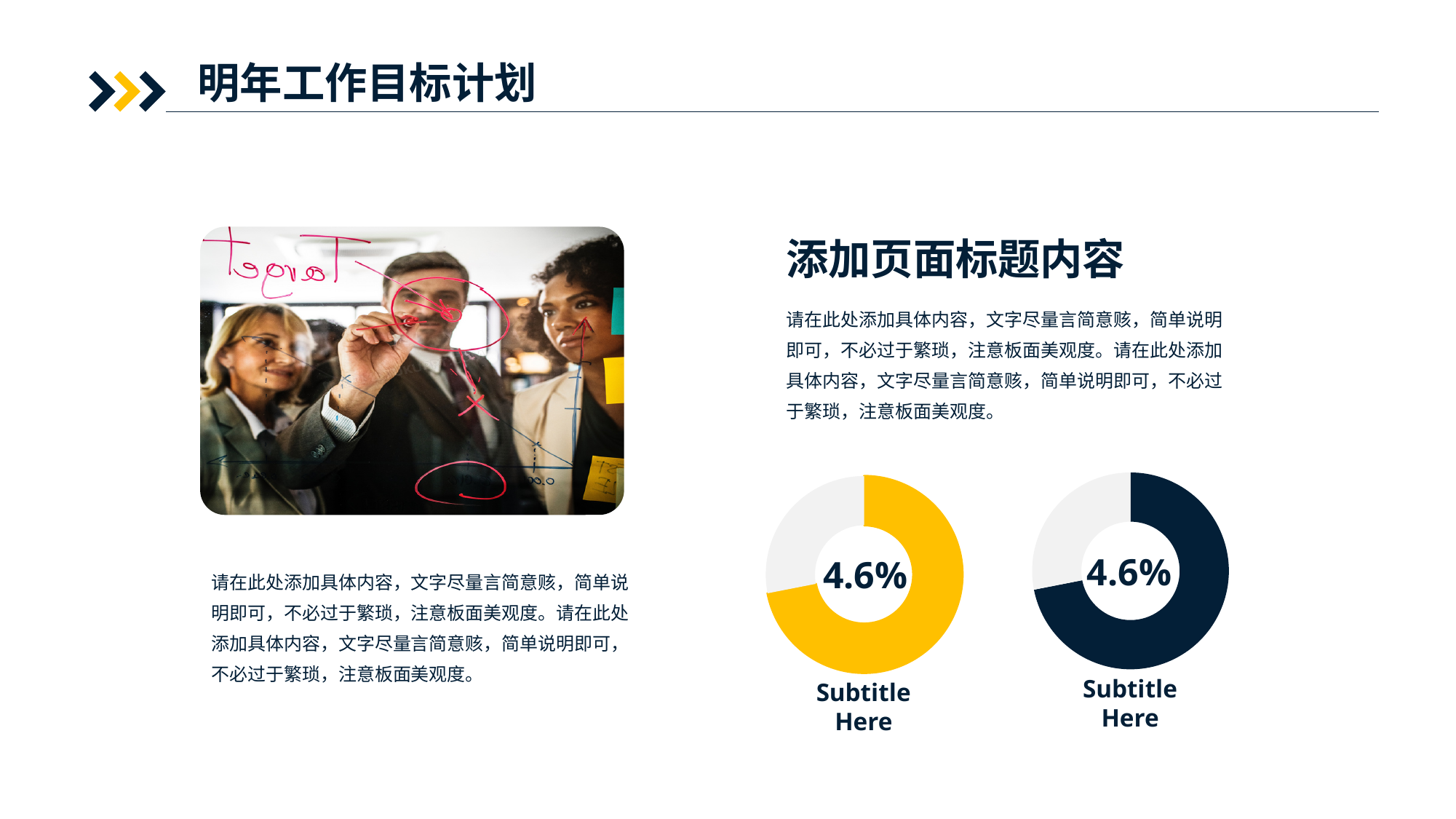
What kind of chart is shown on the left side below the body text? Donut (pie) chart What colour is the filled segment of the left donut chart? Yellow What value is printed in the centre of the right donut chart? 4.6% What kind of chart is shown on the right side below the body text? Donut (pie) chart What value is printed in the centre of the left donut chart? 4.6% What colour is the filled segment of the right donut chart? Dark navy blue How many segments does each donut chart have? 2 Is the value printed in the left donut chart greater or less than 5%? less Is the value printed in the left donut chart larger than, smaller than, or equal to the value printed in the right donut chart? Equal How many donut charts are on the slide? 2